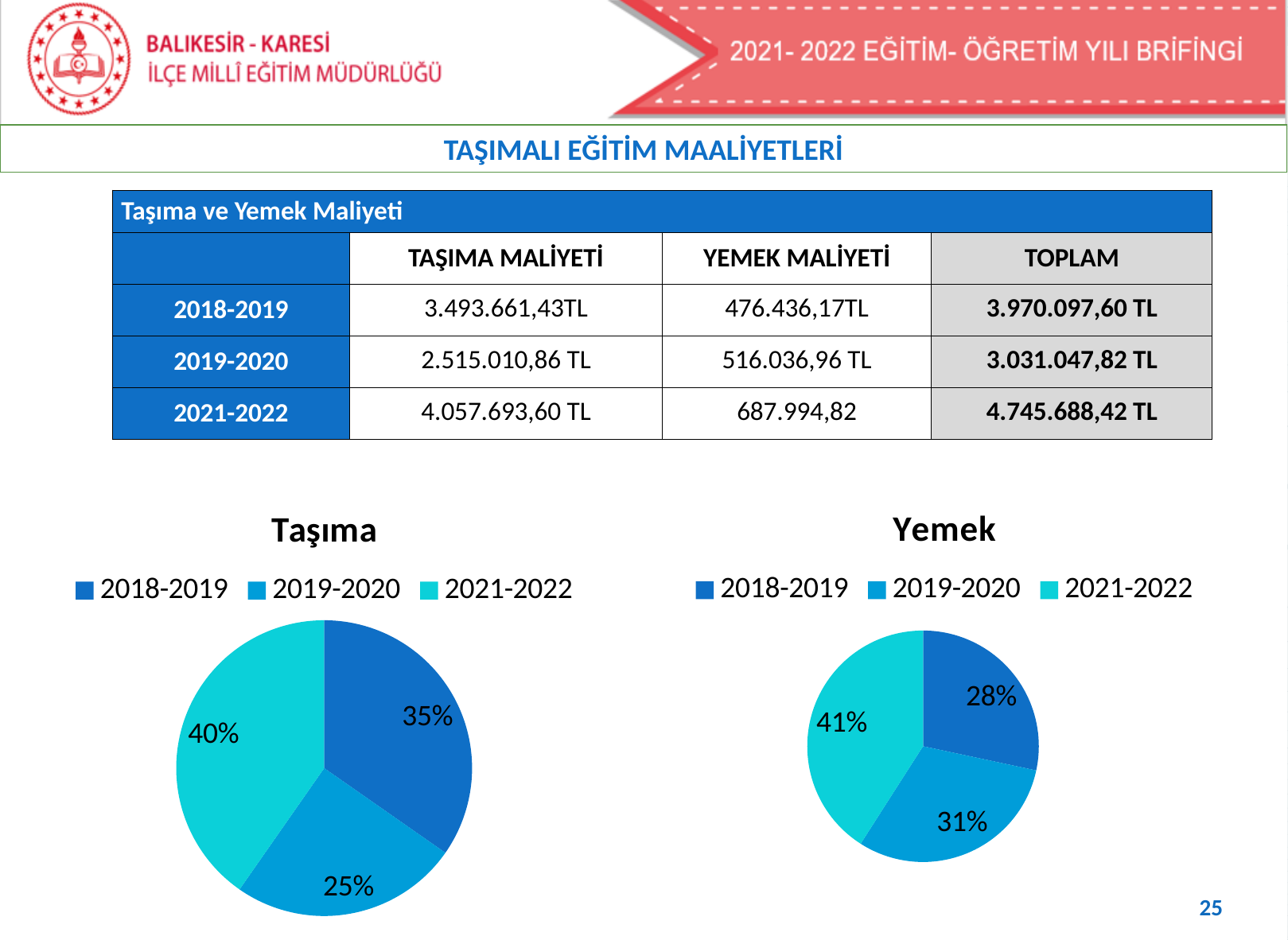
What kind of chart is the Taşıma chart? pie chart In the Taşıma pie chart, which year has the smallest slice? 2019-2020 In the Taşıma pie chart, what share does 2021-2022 have? 40% How many slices does the Yemek pie chart have? 3 In the Yemek pie chart, what is the difference in percentage points between 2021-2022 and 2019-2020? 10 How many entries does the legend of the Taşıma chart list? 3 In the Yemek pie chart, what share does 2021-2022 have? 41% In the Yemek pie chart, which year has the smallest slice? 2018-2019 In the Taşıma pie chart, what share does 2019-2020 have? 25% In the Taşıma pie chart, which year has the largest slice? 2021-2022 In the Taşıma pie chart, which is larger, the 2018-2019 slice or the 2019-2020 slice? 2018-2019